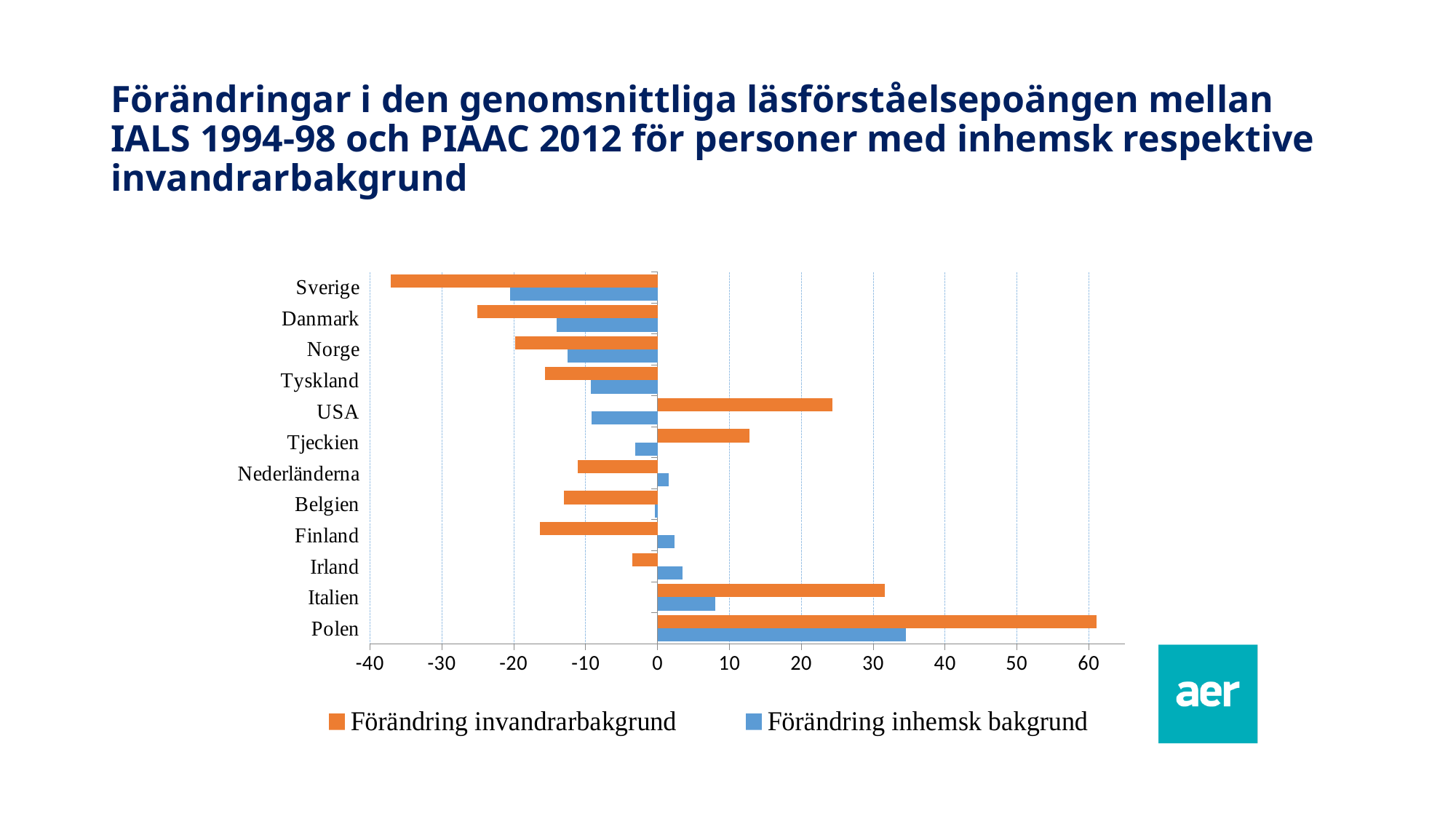
Which is larger for USA: Förändring invandrarbakgrund or Förändring inhemsk bakgrund? Förändring invandrarbakgrund Which colour represents Förändring inhemsk bakgrund in the legend? Blue How many countries are listed on the chart? 12 Which country has the lowest value for Förändring inhemsk bakgrund? Sverige Which country has the lowest value for Förändring invandrarbakgrund? Sverige Is the value for Förändring invandrarbakgrund for Sverige greater or less than -30? less What kind of chart is shown on the slide? Bar chart Which country has the highest value for Förändring inhemsk bakgrund? Polen How many series does the legend list? 2 Is the value for Förändring inhemsk bakgrund for Polen greater or less than 30? greater Which country has the highest value for Förändring invandrarbakgrund? Polen Is the value for Förändring invandrarbakgrund for Polen greater or less than 50? greater